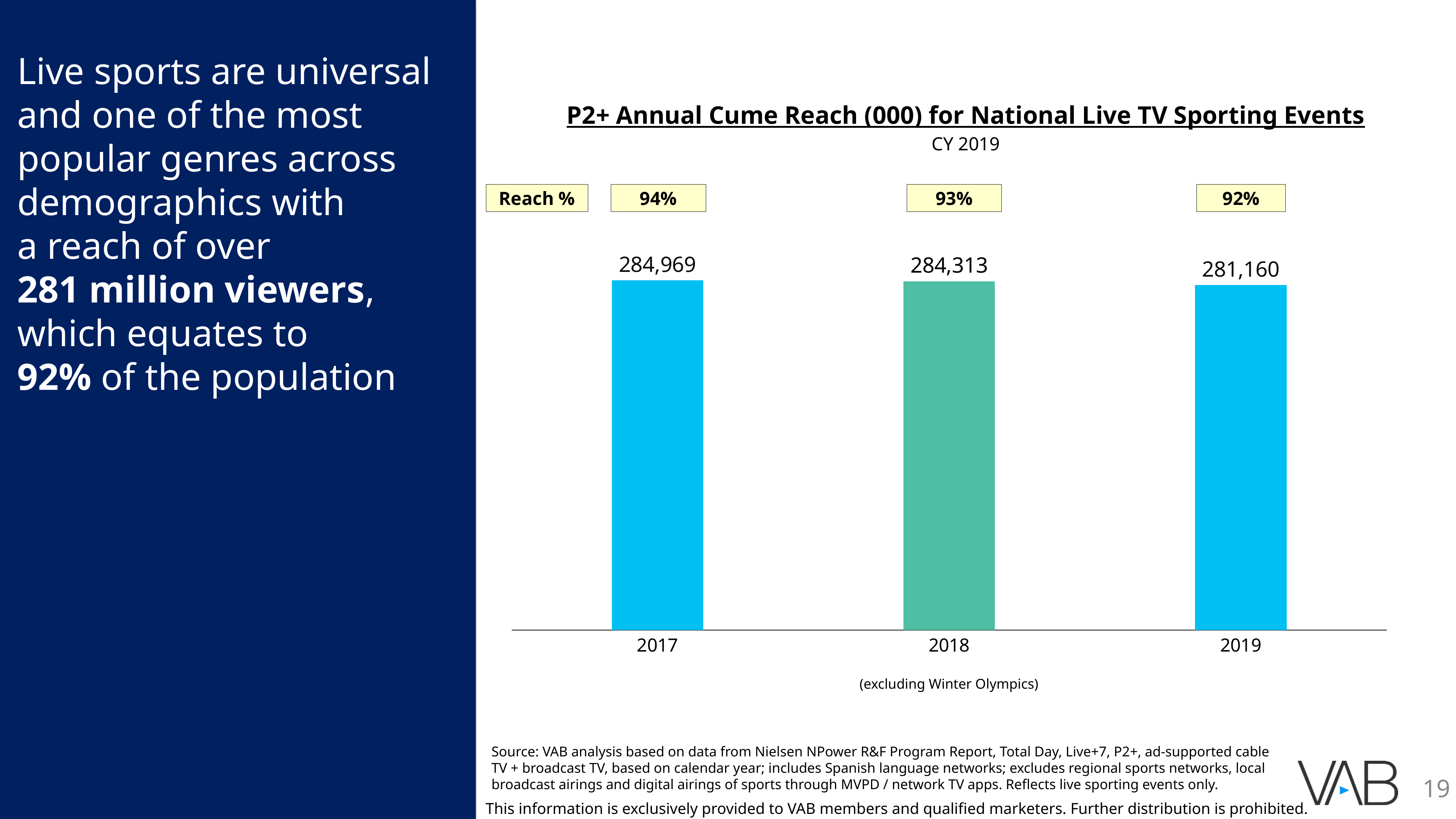
What is the P2+ annual cume reach (000) for 2019? 281,160 What is the P2+ annual cume reach (000) for 2018? 284,313 What is the P2+ annual cume reach (000) for 2017? 284,969 What is the Reach % shown for 2017? 94% Which year has the lowest annual cume reach? 2019 Do the annual cume reach values rise or fall from 2017 to 2019? Fall What is the Reach % shown for 2019? 92% How many years are shown in the chart? 3 What is the difference in annual cume reach (000) between 2017 and 2019? 3,809 Which year has a larger annual cume reach, 2018 or 2019? 2018 What type of chart is shown on the slide? Bar chart Which year has the highest annual cume reach? 2017